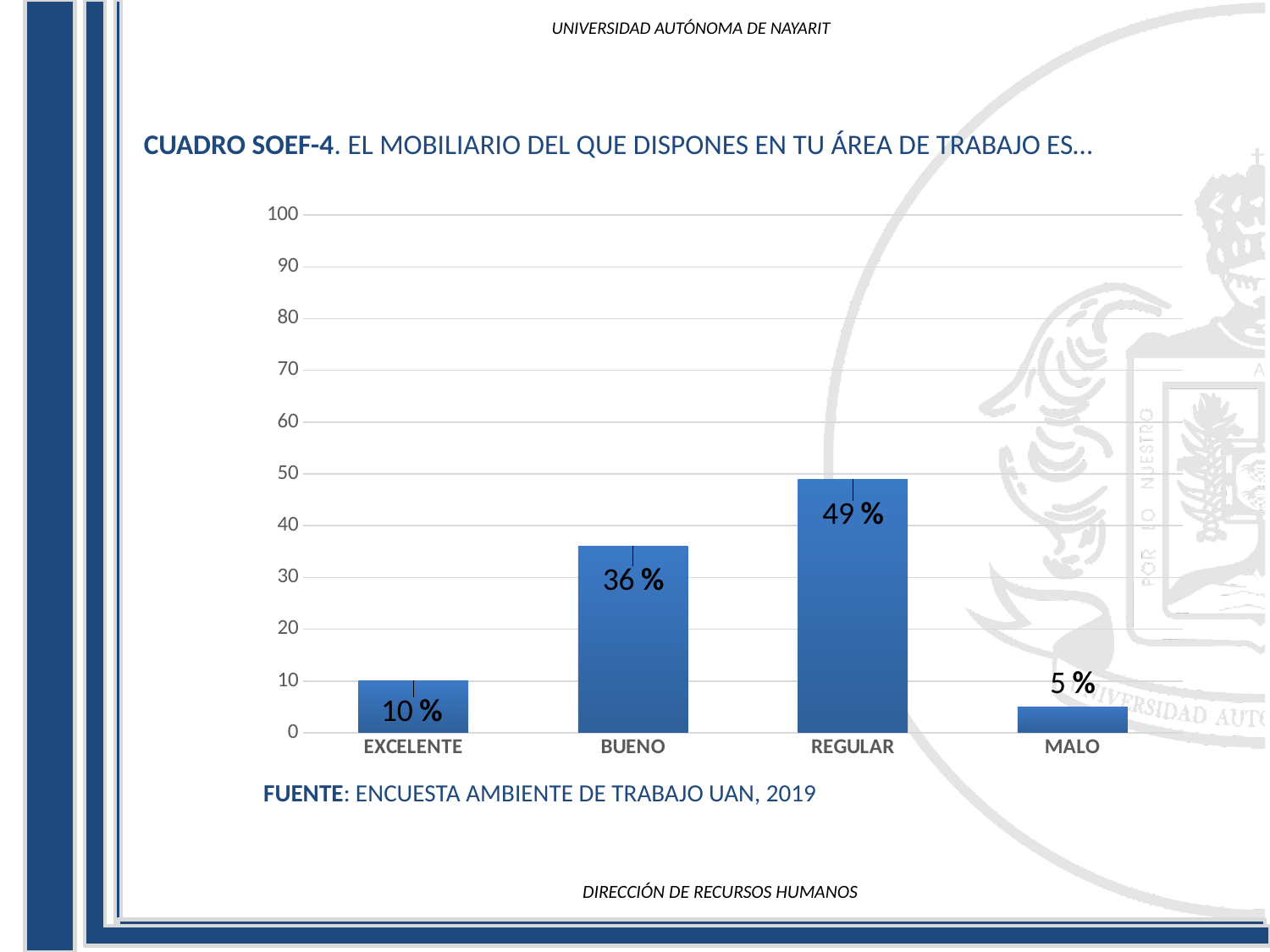
What is the value for BUENO? 36 % Is the value for BUENO greater or less than 40? less Which category has the lowest value? MALO What is the value for EXCELENTE? 10 % What is the value for MALO? 5 % What is the source cited below the chart? ENCUESTA AMBIENTE DE TRABAJO UAN, 2019 What is the value for REGULAR? 49 % How many categories are shown on the x axis? 4 Which is larger, the value for EXCELENTE or the value for MALO? EXCELENTE What is the difference between the values for REGULAR and BUENO? 13 % What kind of chart is shown on the slide? bar chart Which category has the highest value? REGULAR